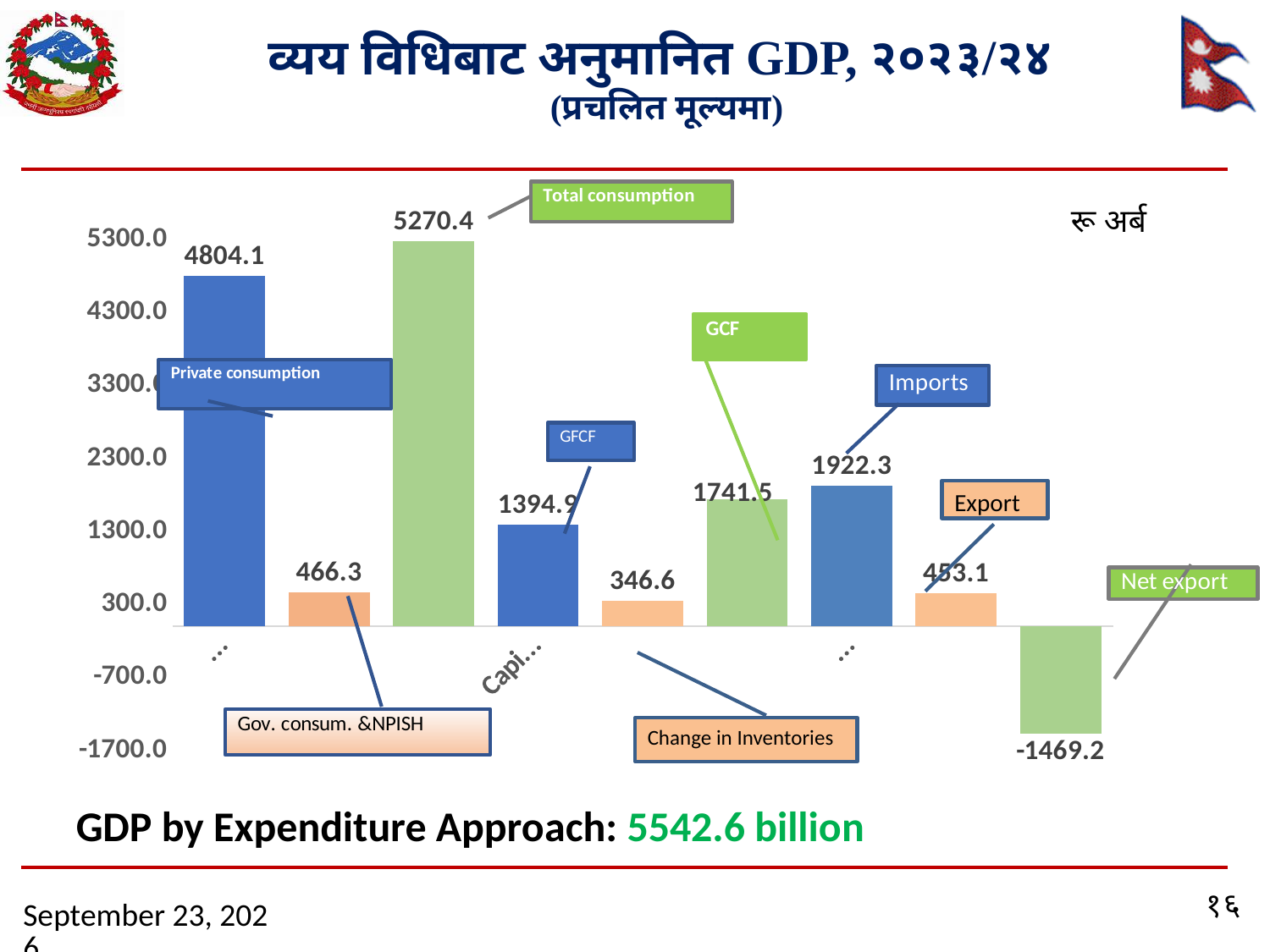
What is the value of the Total consumption bar? 5270.4 Which bar has the highest value? Total consumption Which bar has the lowest value? Net export What is the value of the Net export bar? -1469.2 What is the value of the Change in Inventories bar? 346.6 What is the value of the Private consumption bar? 4804.1 Which is larger, the Imports bar or the GCF bar? Imports Is the value for Private consumption greater or less than 4300? greater What is the value of the Imports bar? 1922.3 What kind of chart is shown on the slide? bar chart How many bars are plotted in the chart? 9 What is the difference between the Imports value and the Export value? 1469.2